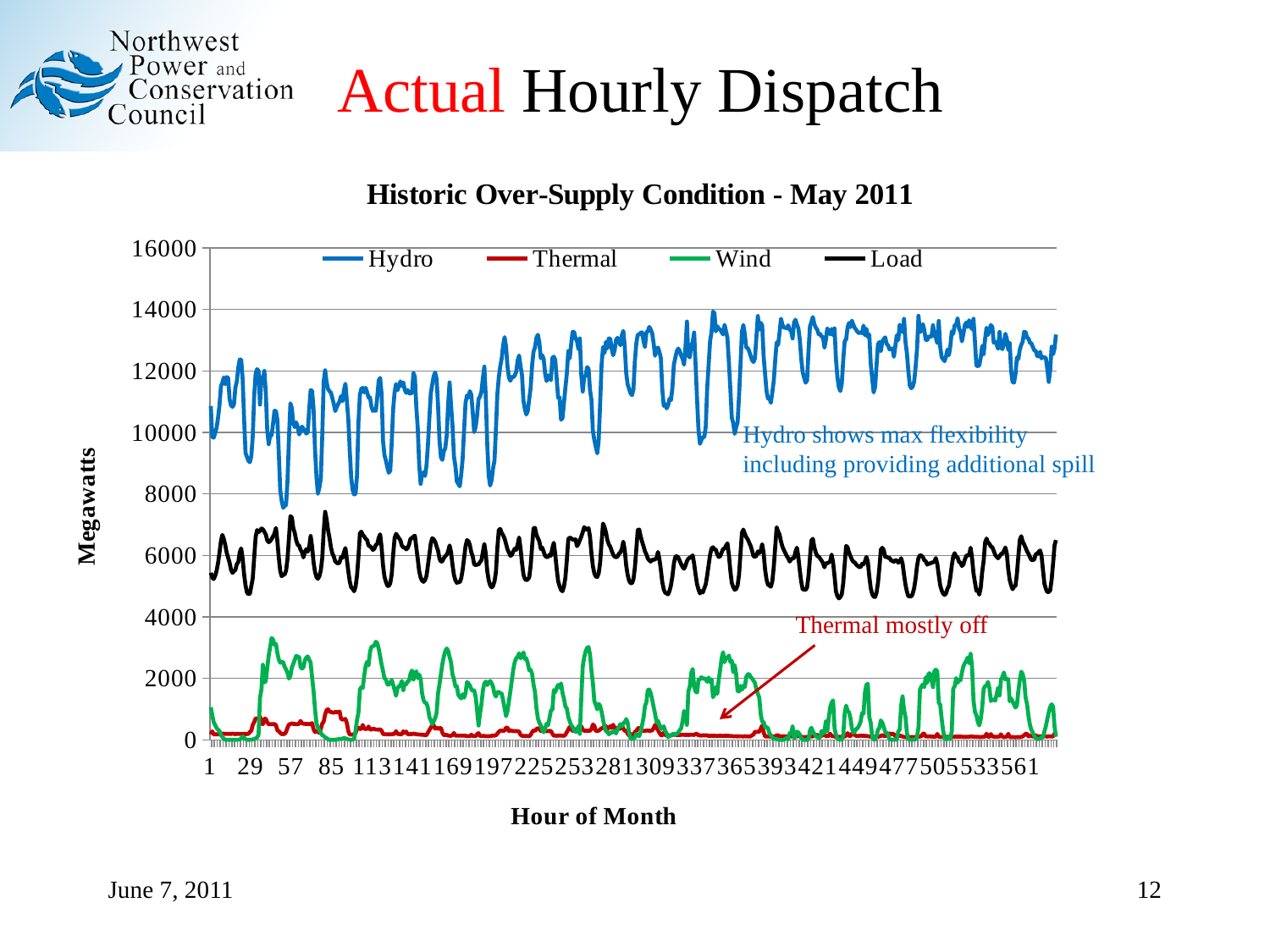
Which series is larger at hour 309, Load or Wind? Load How many series does the legend list? 4 Is the Thermal value at hour 561 greater or less than 2000? less What kind of chart is shown on the slide? line chart Which series has the highest values throughout the month? Hydro Is the Hydro value at hour 1 greater or less than 8000? greater Is the Load value ever greater or less than 8000 during the month? less Does the Hydro series generally rise or fall from the start of the month to the end? rise What is the title of the chart? Historic Over-Supply Condition - May 2011 What is the label on the vertical axis of the chart? Megawatts